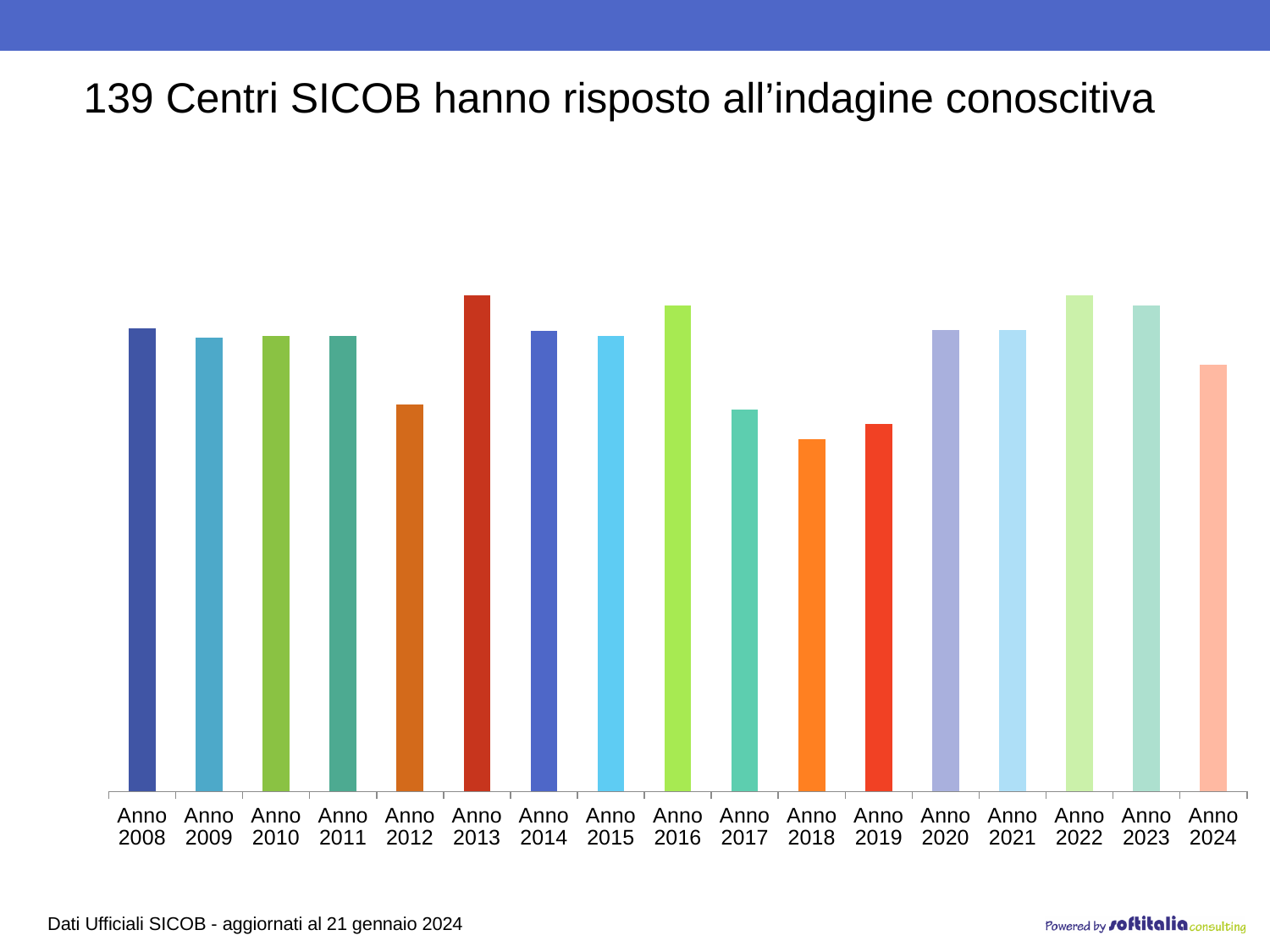
What is the title of the slide above the chart? 139 Centri SICOB hanno risposto all'indagine conoscitiva Which is larger, the value for Anno 2023 or the value for Anno 2024? Anno 2023 Which is larger, the value for Anno 2016 or the value for Anno 2017? Anno 2016 Do the values rise or fall from Anno 2016 to Anno 2018? fall Do the values rise or fall from Anno 2019 to Anno 2022? rise Which is larger, the value for Anno 2012 or the value for Anno 2013? Anno 2013 What kind of chart is shown on the slide? bar chart Which year has the lowest bar? Anno 2018 What is the first year shown on the x axis? Anno 2008 How many years (categories) are plotted on the x axis? 17